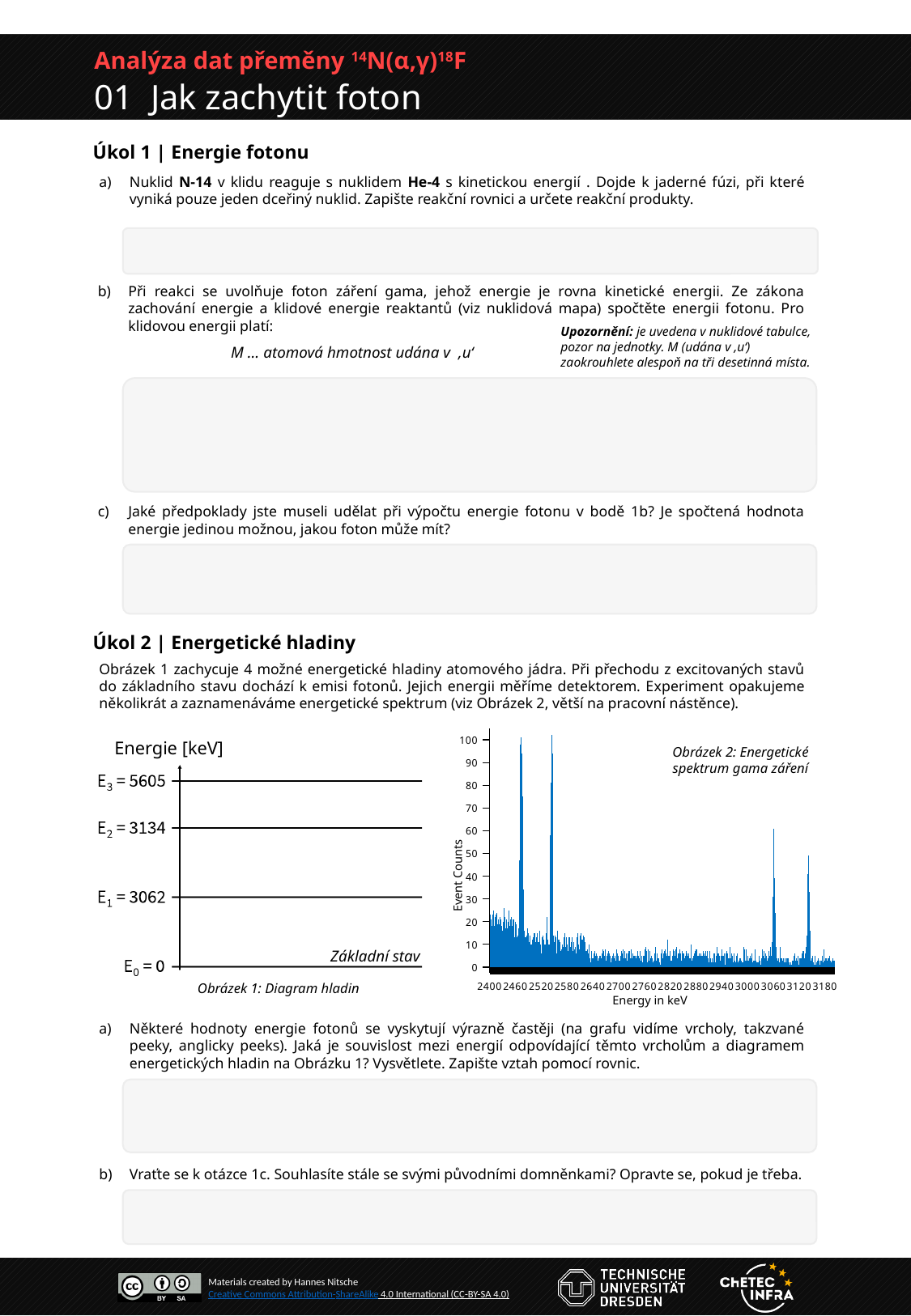
In Obrázek 2 (Energetické spektrum gama záření), what is the highest value shown on the vertical axis? 100 In Obrázek 1 (Diagram hladin), what is the difference in energy between E2 and E1? 72 In Obrázek 2 (Energetické spektrum gama záření), how many prominent peaks are visible in the spectrum? 4 In Obrázek 1 (Diagram hladin), how many energy levels are drawn? 4 In Obrázek 1 (Diagram hladin), what is the energy of level E3? 5605 In Obrázek 2 (Energetické spektrum gama záření), which peak is taller: the one near 2470 keV or the one near 3060 keV? the one near 2470 keV In Obrázek 1 (Diagram hladin), what unit is given for the energy axis? keV In Obrázek 1 (Diagram hladin), what is the energy of level E1? 3062 In Obrázek 2 (Energetické spektrum gama záření), what is the label of the vertical axis? Event Counts In Obrázek 2 (Energetické spektrum gama záření), is the peak near 3060 keV greater or less than 50 event counts? greater In Obrázek 2 (Energetické spektrum gama záření), is the tallest peak near 2470 keV greater or less than 90 event counts? greater In Obrázek 1 (Diagram hladin), which level has the highest energy? E3